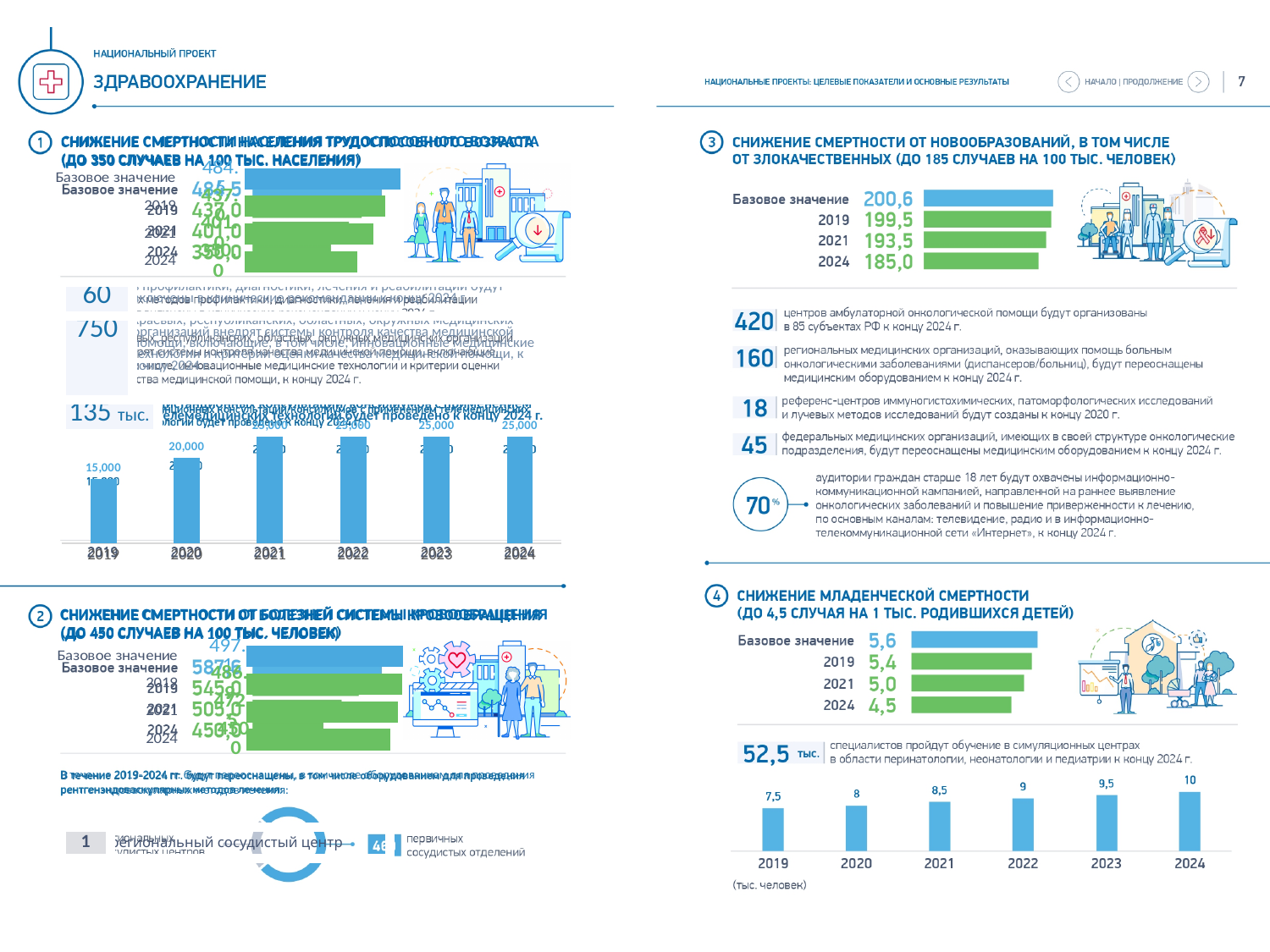
On the chart 'Снижение смертности от новообразований' (top right), what is the 'Базовое значение'? 200,6 What type of chart is the chart at the bottom right labelled '(тыс. человек)'? bar chart On the chart 'Снижение младенческой смертности' (bottom right), how many bars are shown? 4 On the chart 'Снижение смертности от новообразований' (top right), which category has the lowest value? 2024 On the bar chart at the bottom right labelled '(тыс. человек)', what is the difference between the 2024 and 2019 values? 2,5 On the chart 'Снижение младенческой смертности' (bottom right), what is the difference between the 'Базовое значение' and the 2024 value? 1,1 On the chart 'Снижение смертности от новообразований' (top right), do the values rise or fall from the base value to 2024? fall On the chart 'Снижение смертности от новообразований' (top right), what is the value for 2024? 185,0 On the bar chart at the bottom right labelled '(тыс. человек)', what is the value for 2022? 9 On the bar chart at the bottom right labelled '(тыс. человек)', which year has the highest value? 2024 On the chart 'Снижение младенческой смертности' (bottom right), which is larger, the value for 2019 or the value for 2024? 2019 On the chart 'Снижение младенческой смертности' (bottom right), what is the value for 2021? 5,0